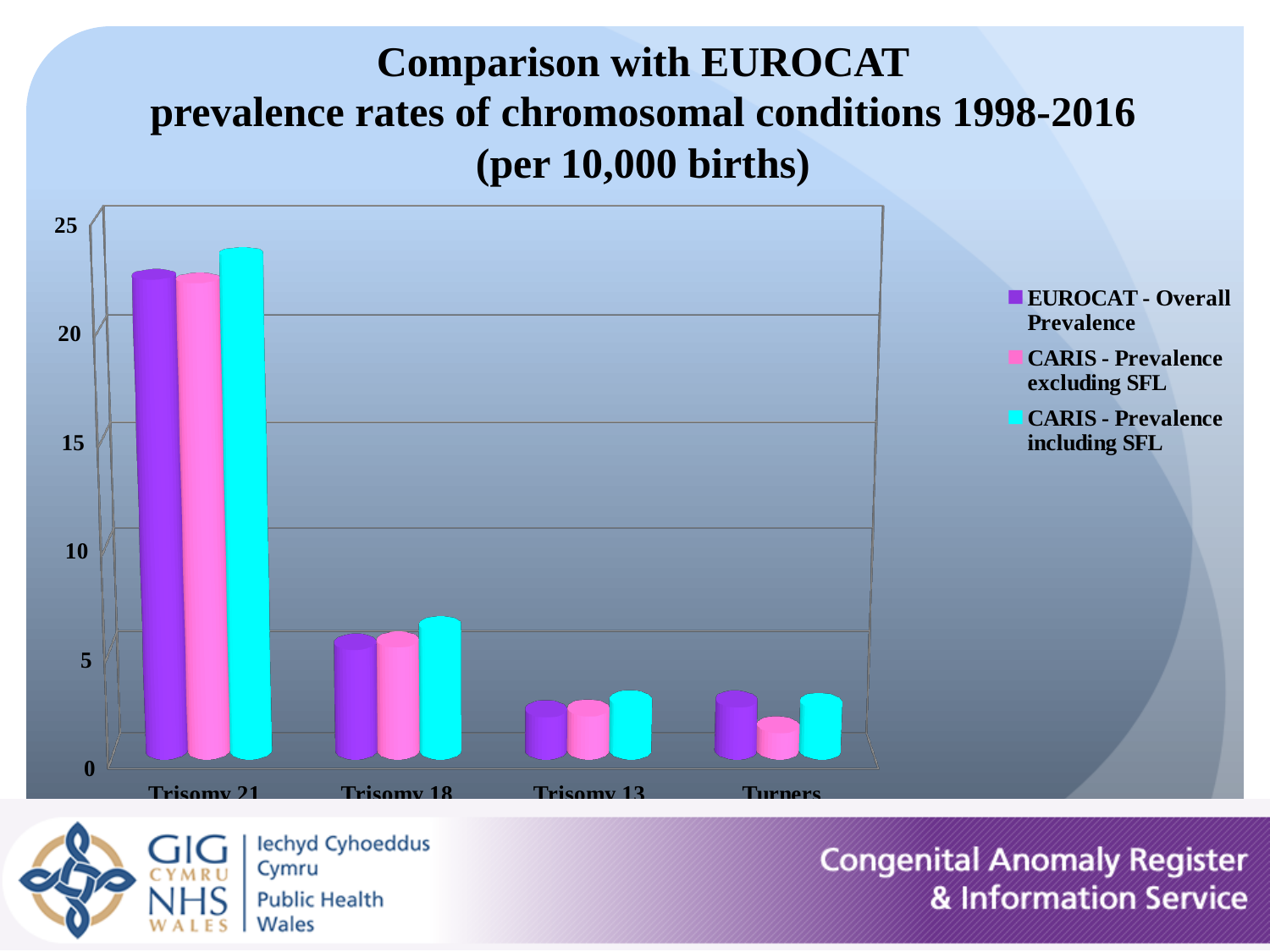
Is the EUROCAT - Overall Prevalence value for Trisomy 21 greater or less than 20? greater Which category has the highest prevalence rates across all series? Trisomy 21 Is the CARIS - Prevalence including SFL value for Trisomy 21 greater or less than 25? less Is the CARIS - Prevalence including SFL value for Trisomy 18 greater or less than 5? greater Which series is shown in cyan in the legend? CARIS - Prevalence including SFL For the EUROCAT - Overall Prevalence series, which is larger: Trisomy 21 or Trisomy 18? Trisomy 21 For Turners, which series has the larger value: EUROCAT - Overall Prevalence or CARIS - Prevalence excluding SFL? EUROCAT - Overall Prevalence How many categories are shown on the x axis of the chart? 4 What kind of chart is shown on the slide? bar chart Which category has the lowest value for the CARIS - Prevalence excluding SFL series? Turners How many series does the legend list? 3